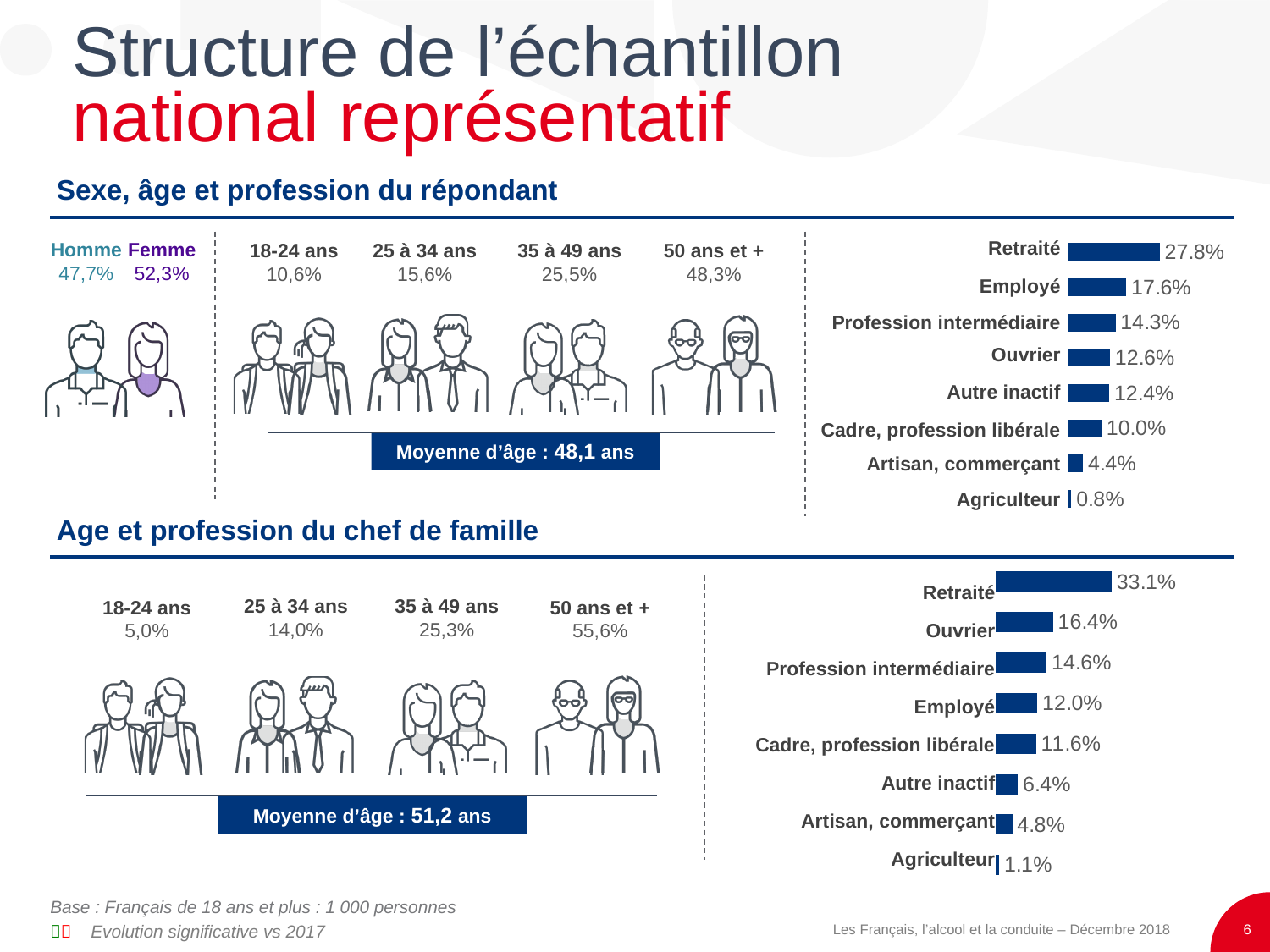
In the top-right bar chart (profession du répondant), what is the difference between Retraité and Employé? 10.2 percentage points In the bottom-right bar chart (profession du chef de famille), what is the difference between Ouvrier and Autre inactif? 10 percentage points In the bottom-right bar chart (profession du chef de famille), which is larger: Employé or Cadre, profession libérale? Employé What type of chart is used to show the profession du chef de famille on the bottom right? Bar chart In the top-right bar chart (profession du répondant), how many categories are shown? 8 In the bottom-right bar chart (profession du chef de famille), what is the value for Retraité? 33.1% In the top-right bar chart (profession du répondant), which category has the highest value? Retraité In the top-right bar chart (profession du répondant), which category has the lowest value? Agriculteur Which is larger: the value for Retraité in the top-right chart or the value for Retraité in the bottom-right chart? Bottom-right chart (33.1%) In the top-right bar chart (profession du répondant), what is the value for Employé? 17.6% In the bottom-right bar chart (profession du chef de famille), which category has the lowest value? Agriculteur In the bottom-right bar chart (profession du chef de famille), what is the value for Ouvrier? 16.4%